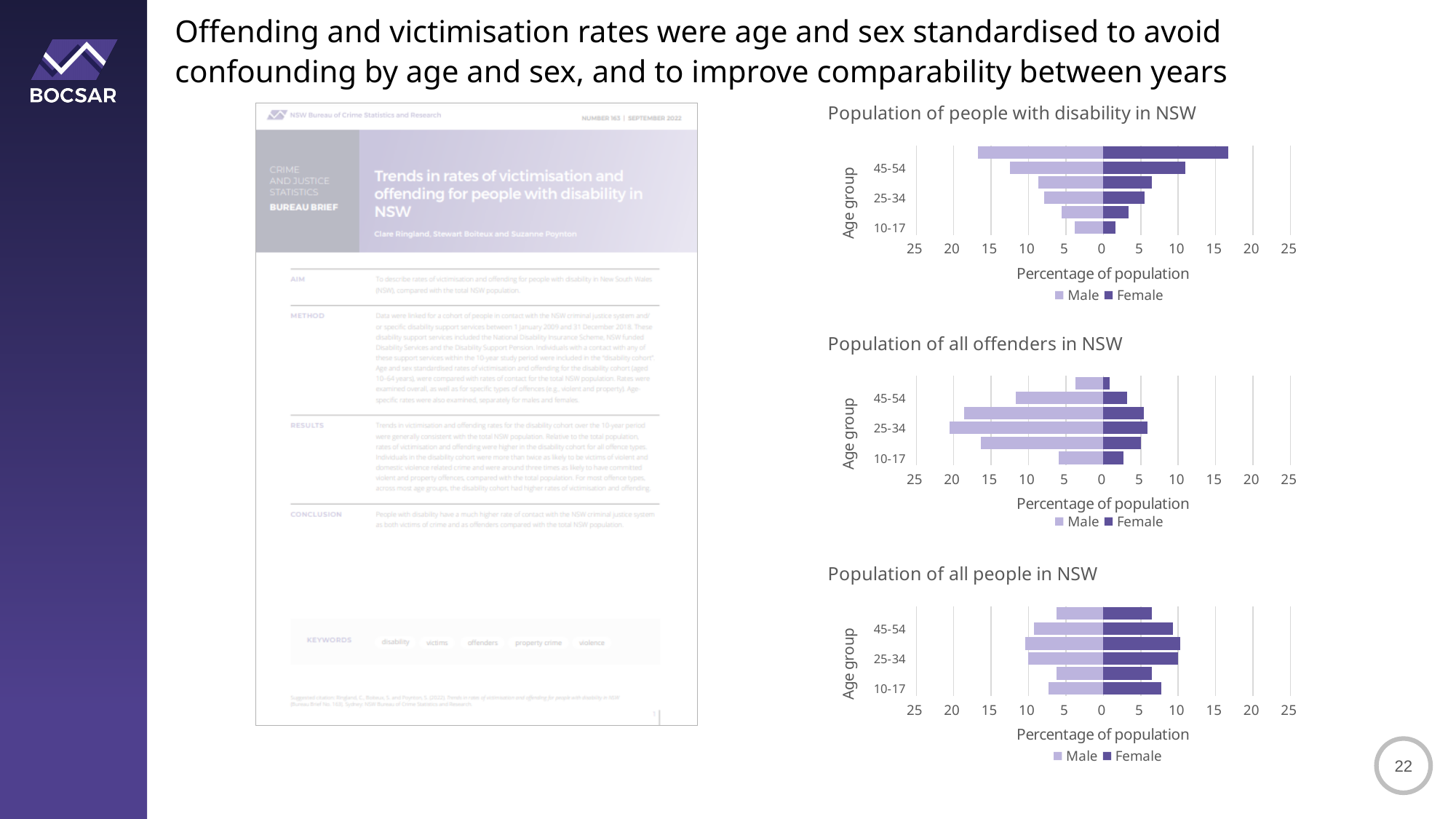
In the 'Population of all people in NSW' chart, is the Male value for the 10-17 age group greater or less than 5? greater In the 'Population of people with disability in NSW' chart, what is the x-axis title? Percentage of population In the 'Population of people with disability in NSW' chart, is the Female value for the 10-17 age group greater or less than 5? less In the 'Population of all offenders in NSW' chart, which is larger for the 25-34 age group, the Male value or the Female value? Male In the 'Population of all offenders in NSW' chart, is the Female value for the 45-54 age group greater or less than 5? less In the 'Population of people with disability in NSW' chart, what kind of chart is it? bar chart In the 'Population of all offenders in NSW' chart, how many series does the legend list? 2 How many charts are shown on the slide? 3 In the 'Population of all offenders in NSW' chart, which age group has the longest Male bar? 25-34 In the 'Population of all people in NSW' chart, what are the two series named in the legend? Male and Female